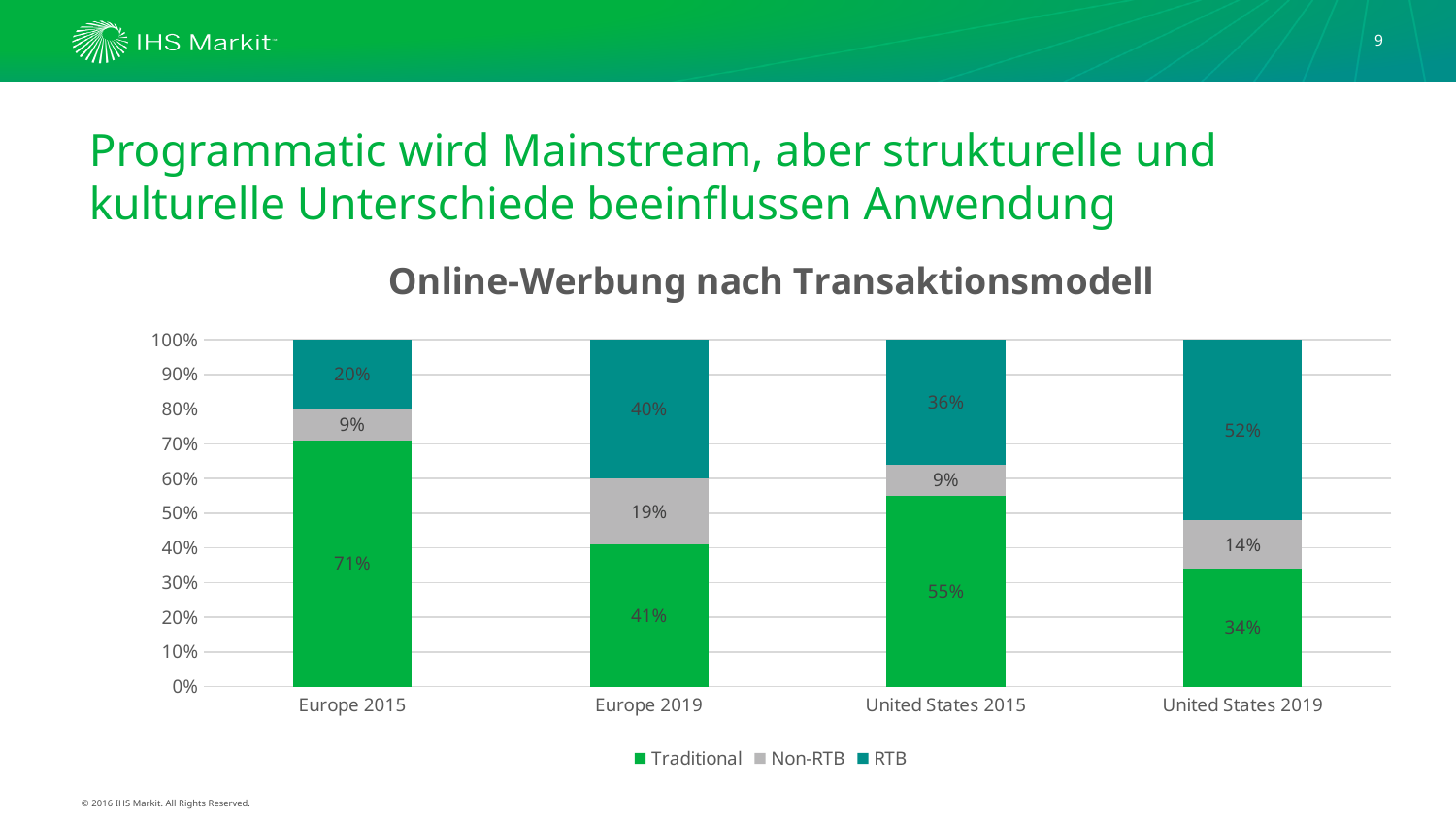
What is the Non-RTB share for Europe 2019? 19% What is the RTB share for United States 2015? 36% What is the RTB share for United States 2019? 52% Which is larger, the Traditional share for Europe 2019 or for United States 2019? Europe 2019 What is the difference between the RTB share for Europe 2019 and Europe 2015? 20% What kind of chart is shown? Stacked bar chart How many categories are shown on the x axis? 4 What is the title of the chart? Online-Werbung nach Transaktionsmodell What is the Traditional share for Europe 2015? 71% How many series does the legend list? 3 Which category has the highest Traditional share? Europe 2015 Which category has the lowest RTB share? Europe 2015